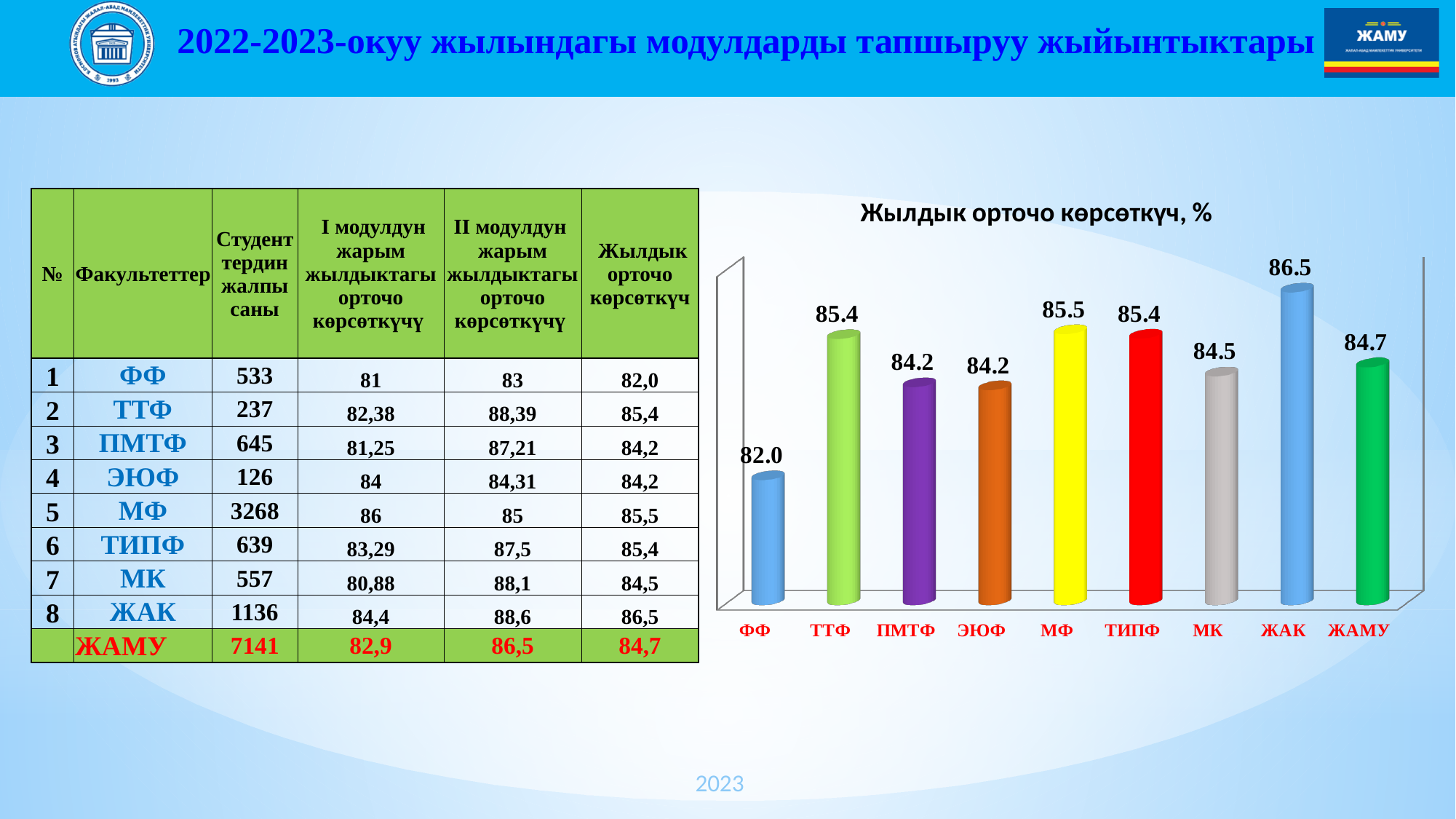
Which category has the highest value in the chart? ЖАК What is the title of the chart? Жылдык орточо көрсөткүч, % Which category has the lowest value in the chart? ФФ What is the value for МК in the chart? 84.5 What is the value for ФФ in the chart? 82.0 Which is larger, the value for МФ or the value for ЭЮФ? МФ How many categories are shown in the chart? 9 What is the difference between the values for ЖАК and ФФ? 4.5 What is the value for ЖАМУ in the chart? 84.7 What is the value for ЖАК in the chart? 86.5 What is the difference between the values for МФ and МК? 1.0 What kind of chart is shown on the slide? bar chart